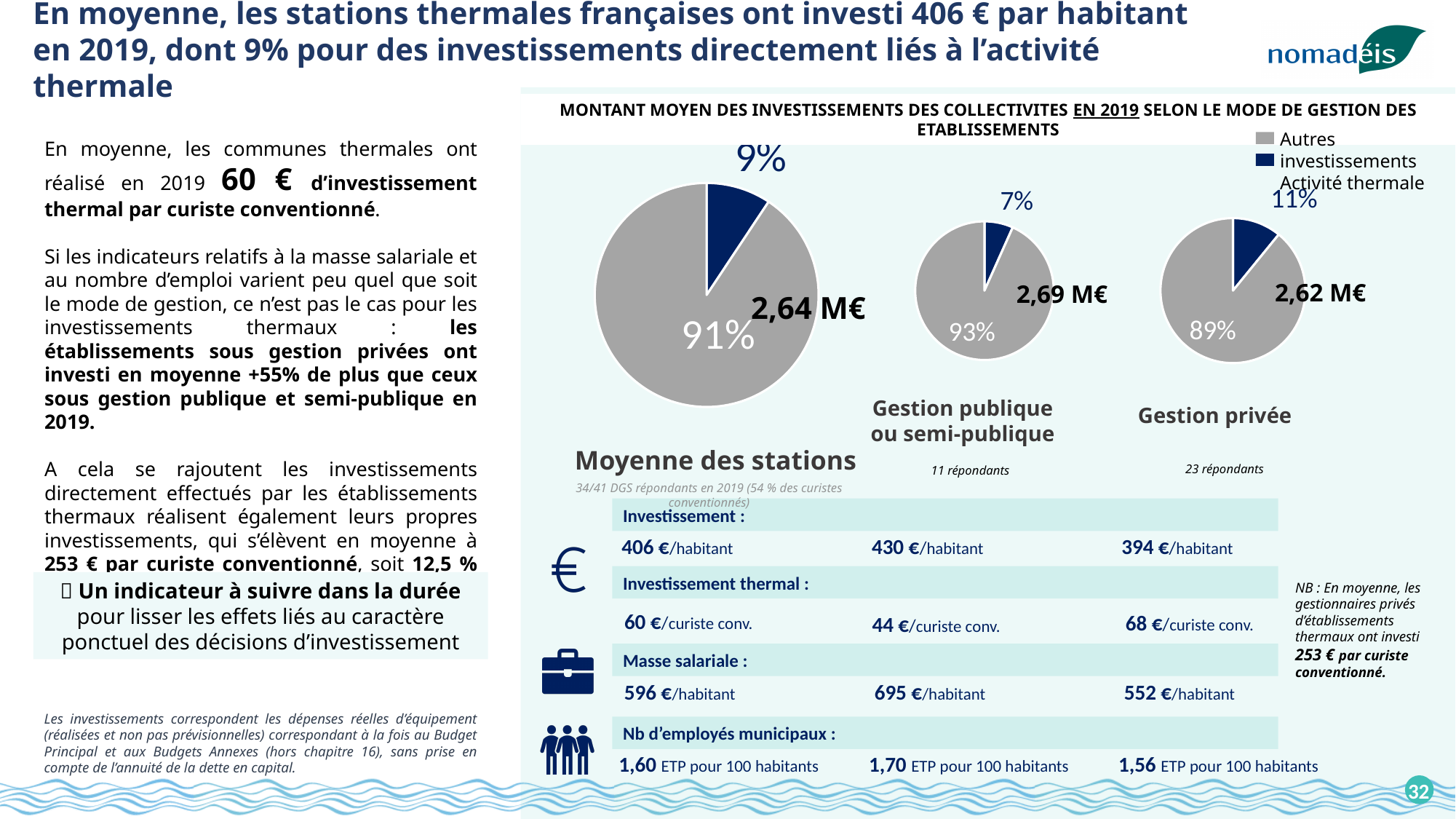
How many series does the legend of the pie charts list? 2 What kind of chart is used to show the breakdown of investments for 'Moyenne des stations'? pie chart In the 'Gestion publique ou semi-publique' pie chart, what share is labelled for 'Activité thermale'? 7% In the 'Gestion privée' pie chart, what share is labelled for 'Autres investissements'? 89% In the 'Moyenne des stations' pie chart, what share is labelled for 'Activité thermale'? 9% Which of the three pie charts shows the smallest share for 'Activité thermale'? Gestion publique ou semi-publique Which of the three pie charts shows the largest share for 'Activité thermale'? Gestion privée What is the difference in percentage points between the 'Activité thermale' share in the 'Gestion privée' pie chart and in the 'Gestion publique ou semi-publique' pie chart? 4 percentage points What total amount is printed next to the 'Gestion publique ou semi-publique' pie chart? 2,69 M€ What total amount is printed next to the 'Gestion privée' pie chart? 2,62 M€ How many pie charts are shown on the slide? 3